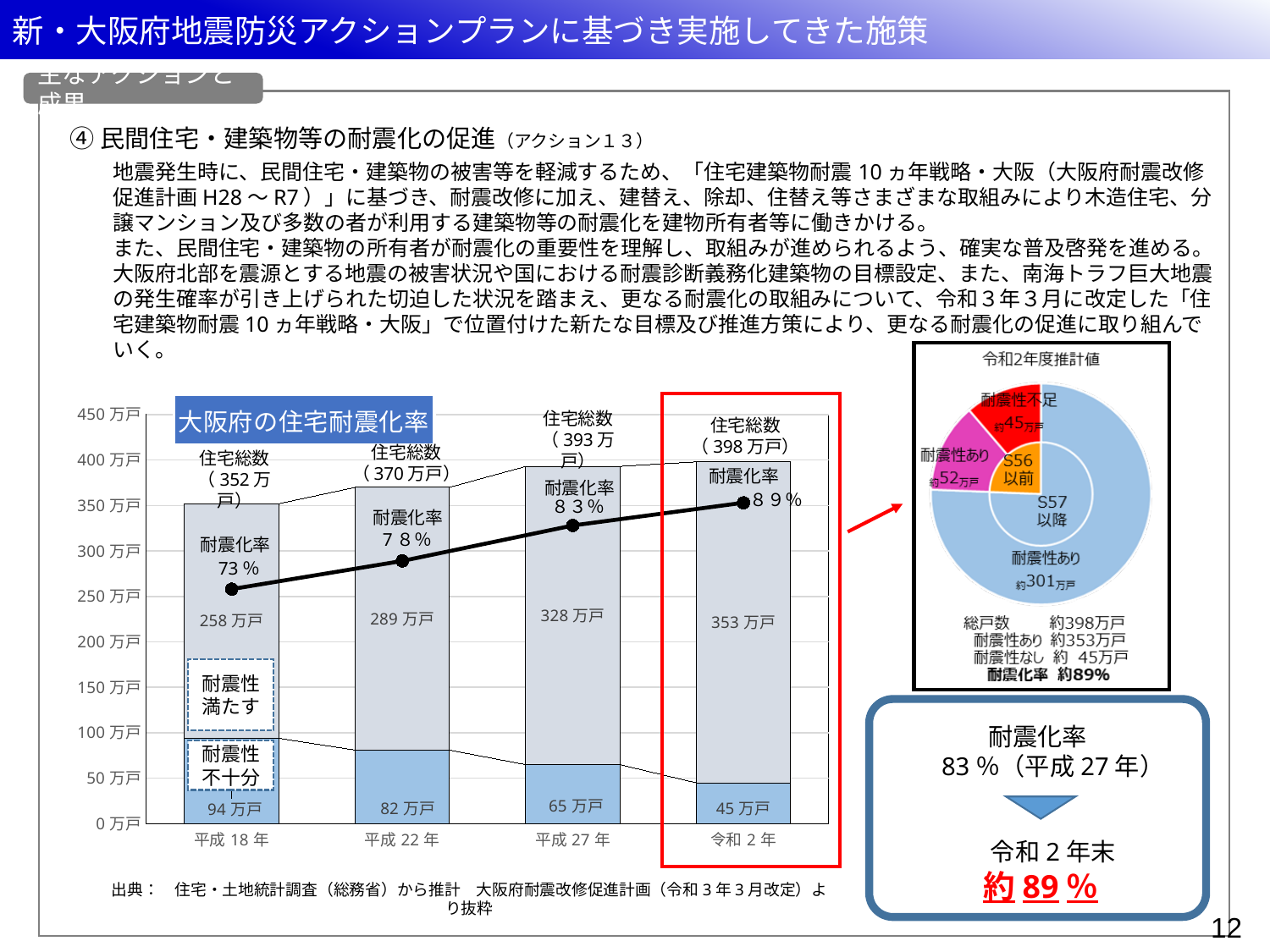
In the chart titled 大阪府の住宅耐震化率, what is the difference between the 耐震性不十分 values for 平成18年 and 令和2年? 49 万戸 In the chart titled 大阪府の住宅耐震化率, how many 万戸 of housing are labelled 耐震性満たす for 平成27年? 328 万戸 In the chart titled 大阪府の住宅耐震化率, which year has the highest 耐震化率? 令和2年 In the chart titled 大阪府の住宅耐震化率, what is the 住宅総数 for 令和2年? 398 万戸 In the chart titled 大阪府の住宅耐震化率, how many years are shown on the x axis? 4 In the chart titled 大阪府の住宅耐震化率, what is the total of the stacked bar for 平成22年? 370 万戸 In the pie chart titled 令和2年度推計値, how many 万戸 are labelled 耐震性不足? 約45万戸 In the pie chart titled 令和2年度推計値, what is the 耐震化率 stated below the chart? 約89% In the chart titled 大阪府の住宅耐震化率, does the 耐震化率 rise or fall from 平成18年 to 令和2年? rise In the chart titled 大阪府の住宅耐震化率, is the 耐震性満たす value for 平成22年 larger or smaller than that for 平成27年? smaller In the chart titled 大阪府の住宅耐震化率, which year has the lowest 耐震性不十分 value? 令和2年 In the chart titled 大阪府の住宅耐震化率, what is the 耐震化率 for 平成18年? 73%